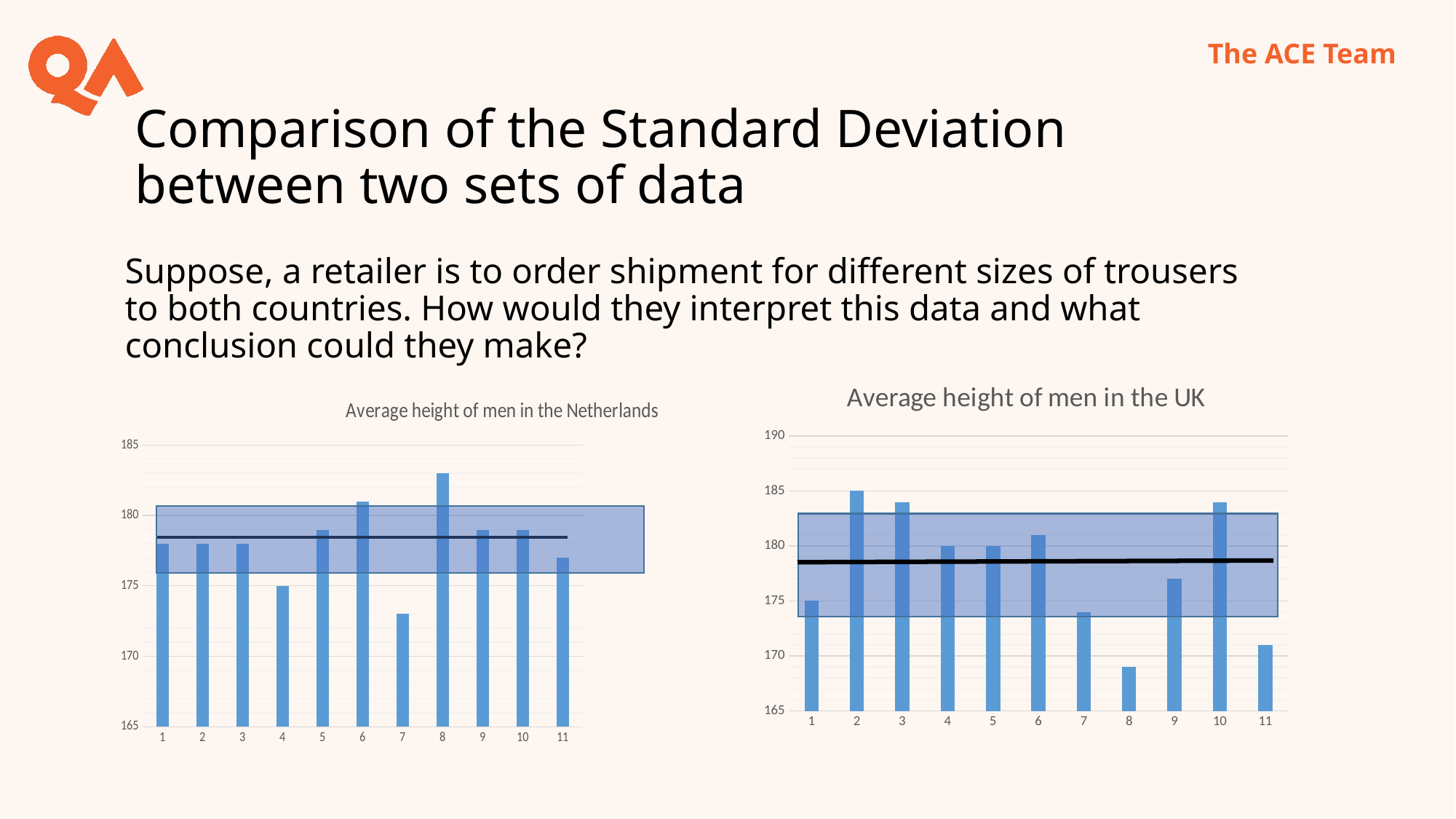
In the 'Average height of men in the Netherlands' chart, which category has the shortest bar? 7 In the 'Average height of men in the UK' chart, which category has the shortest bar? 8 In the 'Average height of men in the UK' chart, which is larger, the value for category 2 or category 8? category 2 In the 'Average height of men in the Netherlands' chart, what is the value for category 4? 175 In the 'Average height of men in the Netherlands' chart, is the value for category 8 greater or less than 180? greater What is the title of the chart on the right of the slide? Average height of men in the UK How many bars are plotted in the 'Average height of men in the UK' chart? 11 In the 'Average height of men in the UK' chart, what is the value for category 2? 185 In the 'Average height of men in the UK' chart, is the value for category 8 greater or less than 170? less In the 'Average height of men in the UK' chart, what is the value for category 1? 175 In the 'Average height of men in the Netherlands' chart, which category has the tallest bar? 8 What type of chart is 'Average height of men in the Netherlands'? bar chart